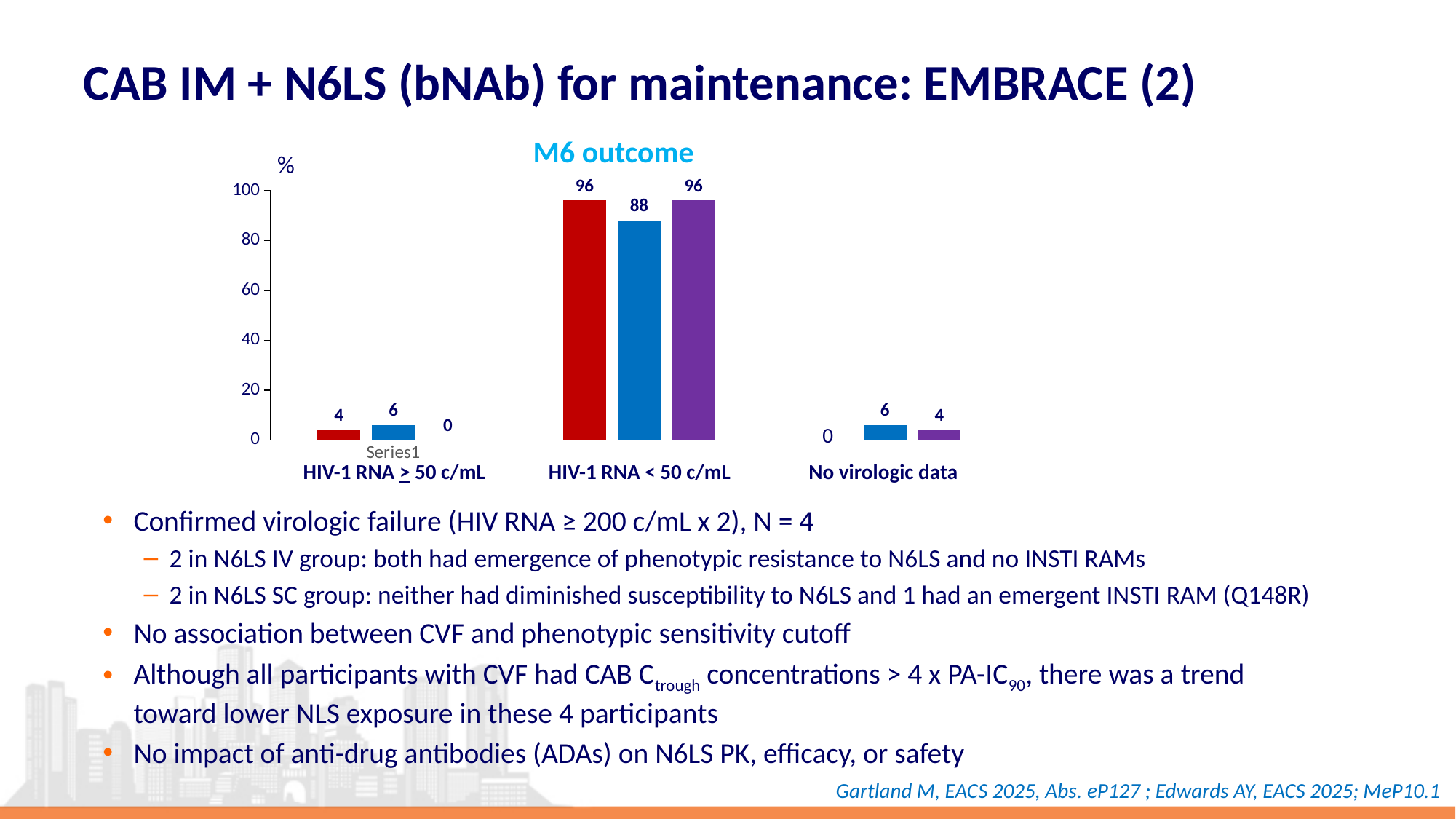
What is the difference between the red bar and the blue bar for HIV-1 RNA < 50 c/mL? 8 How many categories are shown on the x axis? 3 What is the value of the blue bar for HIV-1 RNA < 50 c/mL? 88 What is the value of the purple bar for HIV-1 RNA ≥ 50 c/mL? 0 What is the value of the red bar for HIV-1 RNA < 50 c/mL? 96 What is the value of the red bar for HIV-1 RNA ≥ 50 c/mL? 4 For HIV-1 RNA ≥ 50 c/mL, which is larger, the red bar or the blue bar? the blue bar Which category has the highest values across all bars? HIV-1 RNA < 50 c/mL What kind of chart is shown on the slide? bar chart Is the value of the blue bar for HIV-1 RNA < 50 c/mL greater or less than 80? greater What is the title of the chart? M6 outcome What is the value of the blue bar for No virologic data? 6